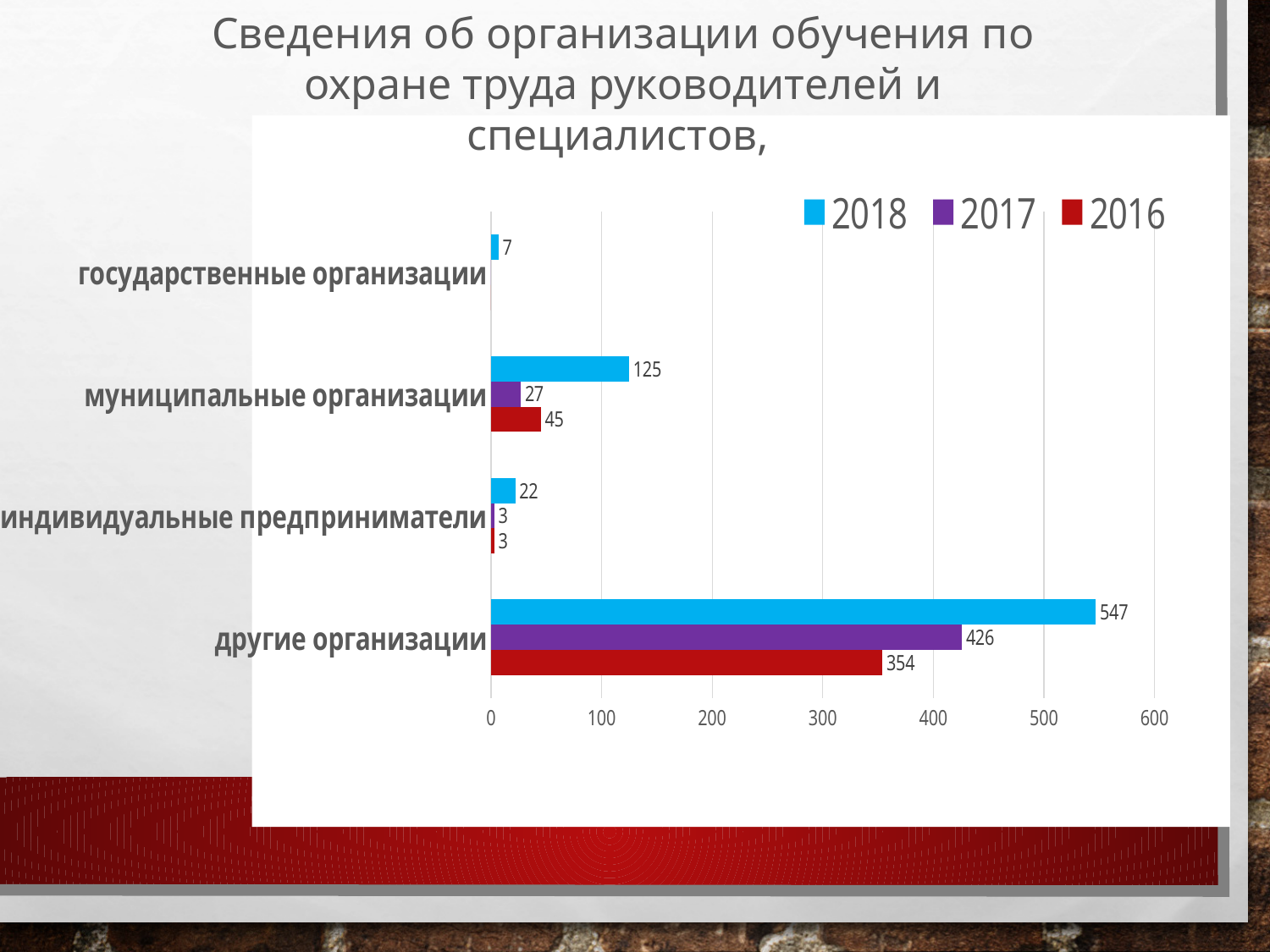
Is the value for другие организации in 2016 greater or less than 300? greater How many series does the legend list? 3 What is the difference between the 2018 and 2017 values for другие организации? 121 What is the value for государственные организации in 2018? 7 What is the value for индивидуальные предприниматели in 2017? 3 How many categories are shown on the chart? 4 What is the value for муниципальные организации in 2016? 45 Which category has the highest value in the 2018 series? другие организации Which category has the lowest value in the 2018 series? государственные организации What is the value for другие организации in 2018? 547 What kind of chart is shown on the slide? bar chart Which is larger for муниципальные организации: the 2018 value or the 2016 value? 2018